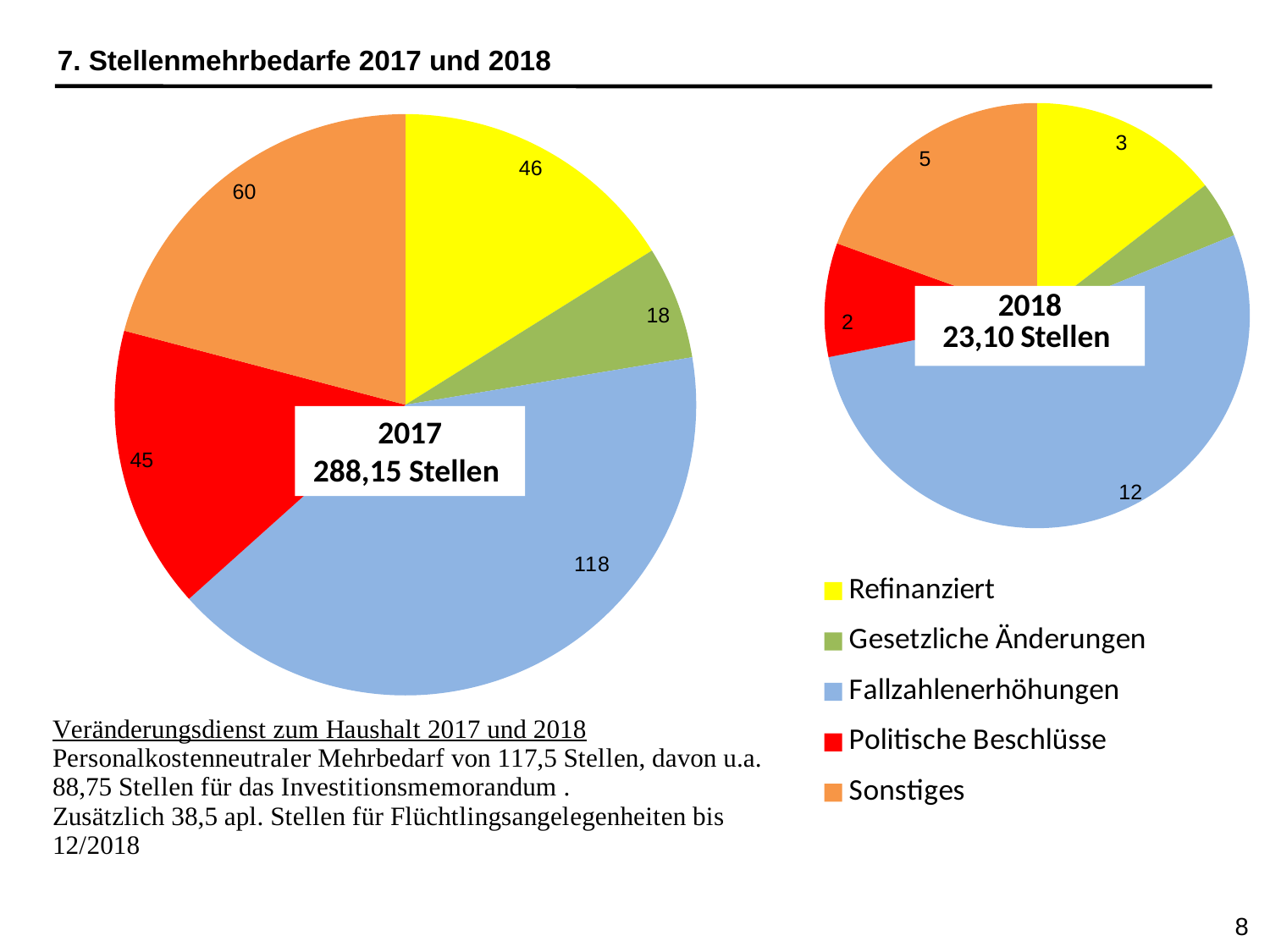
What kind of charts are shown on the slide? Pie charts What total number of Stellen is shown in the centre of the 2018 pie chart? 23,10 Stellen In the 2018 pie chart, which category has the largest slice? Fallzahlenerhöhungen In the 2017 pie chart, what is the difference between the values for Fallzahlenerhöhungen and Refinanziert? 72 In the 2017 pie chart, which category has the largest slice? Fallzahlenerhöhungen How many categories does the legend list? 5 In the 2017 pie chart, what is the value for Sonstiges? 60 In the 2018 pie chart, what is the value for Fallzahlenerhöhungen? 12 In the 2018 pie chart, what is the value for Politische Beschlüsse? 2 In the 2017 pie chart, which category has the smallest slice? Gesetzliche Änderungen In the 2017 pie chart, what is the value for Fallzahlenerhöhungen? 118 In the 2018 pie chart, which is larger, Sonstiges or Refinanziert? Sonstiges